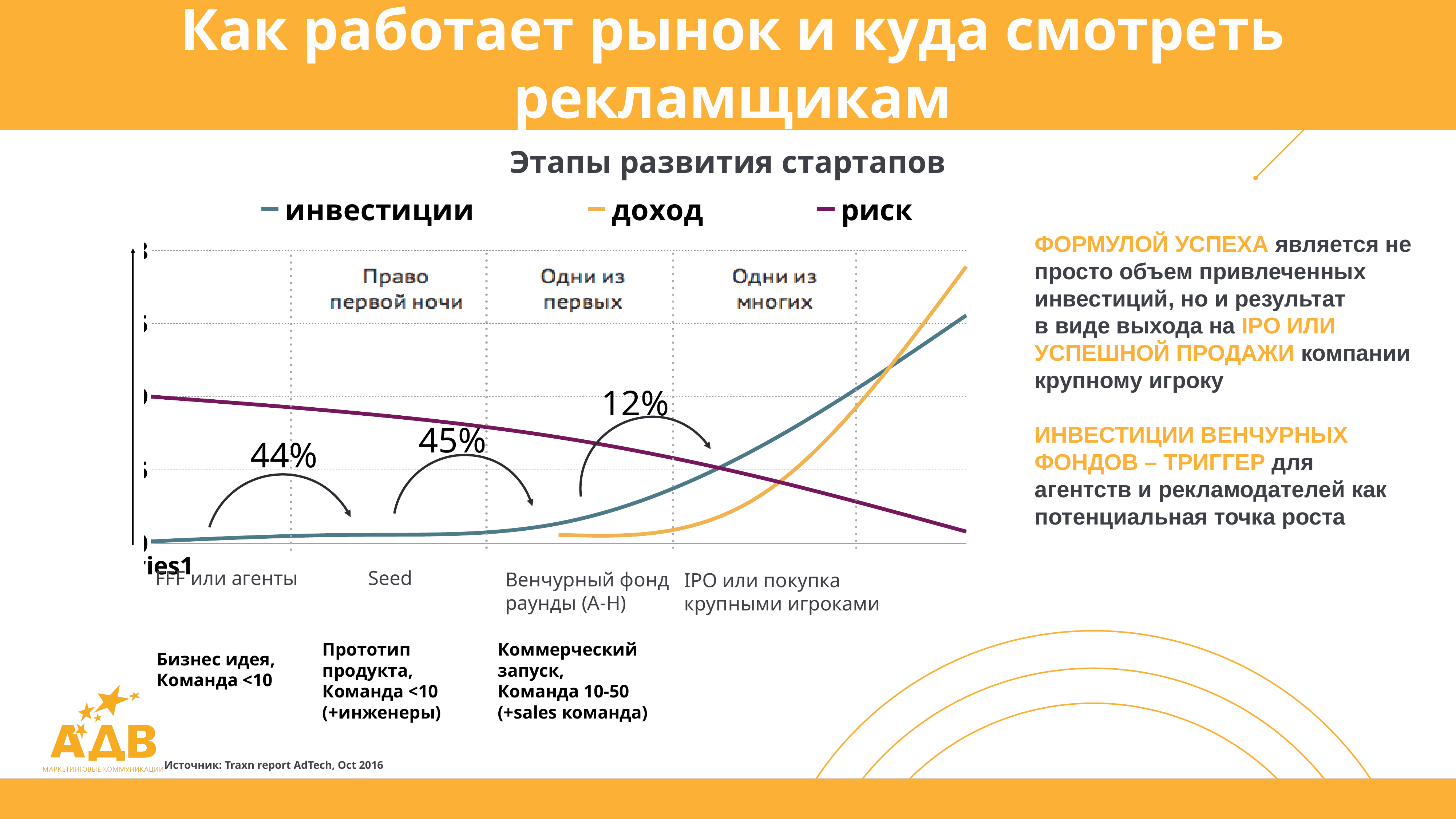
What are the three series named in the chart legend? инвестиции, доход, риск Does the 'инвестиции' line rise or fall from left to right across the chart? rises How many series does the legend of the chart list? 3 How many startup stages are labelled along the x axis of the chart? 4 What is the title of the chart? Этапы развития стартапов What kind of chart is shown under the title 'Этапы развития стартапов'? line chart Which series has the lowest value at the rightmost point of the chart? риск At the right end of the chart, which series is higher: 'доход' or 'инвестиции'? доход Does the 'доход' line rise or fall as it moves toward the 'IPO или покупка крупными игроками' stage? rises At the 'FFF или агенты' stage, which series is higher: 'риск' or 'инвестиции'? риск Does the 'риск' line rise or fall from left to right across the chart? falls Which series has the highest value at the leftmost point of the chart? риск